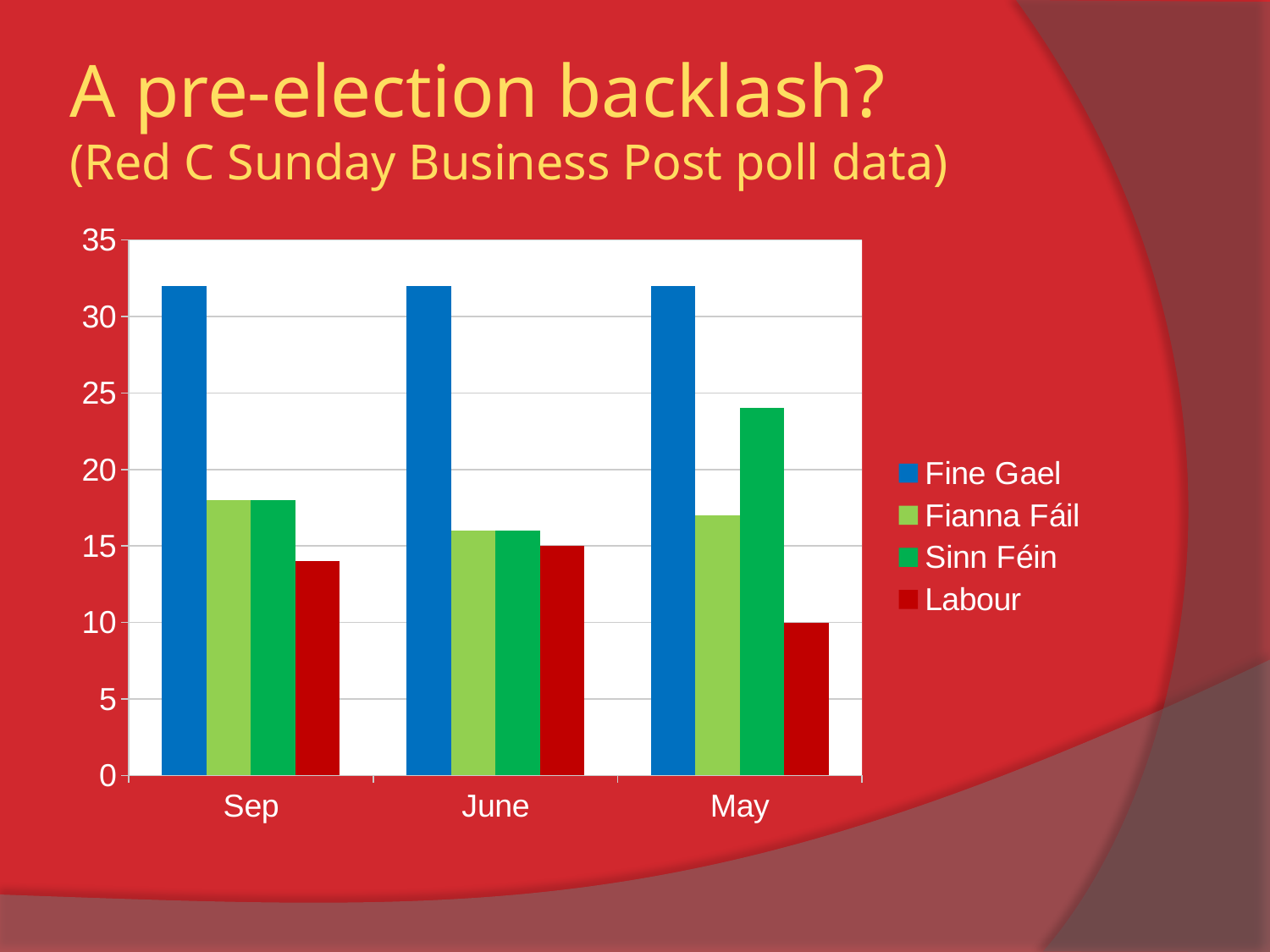
Which party has the lowest value in May? Labour Is the value for Fine Gael in Sep greater or less than 30? greater What kind of chart is shown on the slide? bar chart Which party has the highest value in Sep? Fine Gael In May, which is larger: Sinn Féin or Fianna Fáil? Sinn Féin What is the value for Labour in May? 10 What is the value for Labour in June? 15 How many month categories are shown on the x axis? 3 How many series does the legend list? 4 Is the value for Sinn Féin in May greater or less than 20? greater Is the value for Fianna Fáil in June greater or less than 20? less Which legend entry is shown in dark red? Labour